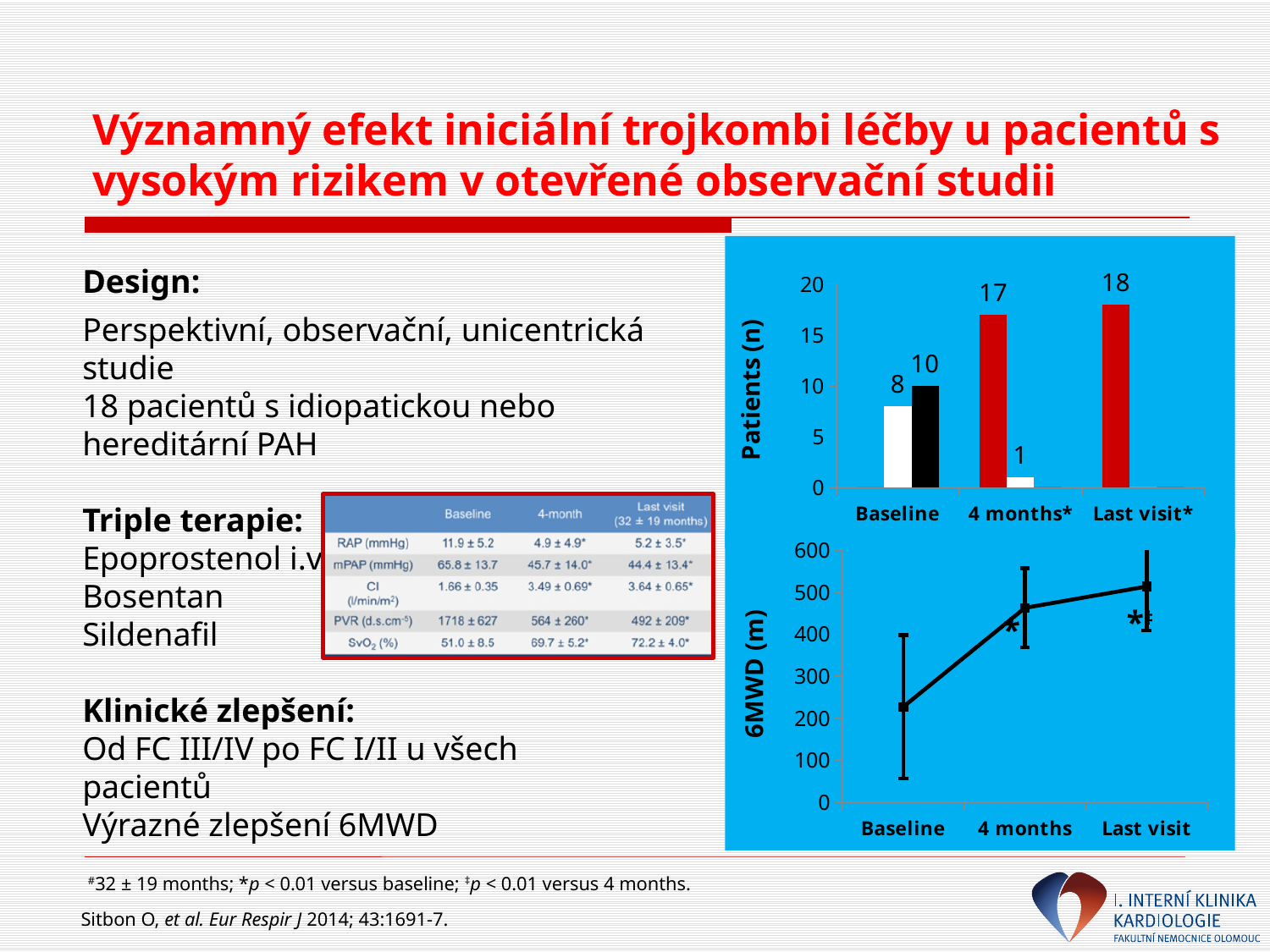
In the bottom chart (6MWD (m)), do the values rise or fall from Baseline to Last visit? rise In the top chart (Patients (n)), what is the value of the red bar at Last visit*? 18 In the top chart (Patients (n)), what is the value of the black bar at Baseline? 10 In the bottom chart (6MWD (m)), is the value at Baseline greater or less than 300? less In the top chart (Patients (n)), what is the difference between the red bar at Last visit* and the red bar at 4 months*? 1 In the top chart (Patients (n)), what is the value of the white bar at Baseline? 8 In the top chart (Patients (n)), what is the value of the red bar at 4 months*? 17 In the top chart (Patients (n)), which category has the tallest bar? Last visit* What type of chart is the bottom chart (6MWD (m))? line chart In the top chart (Patients (n)), what is the difference between the black bar and the white bar at Baseline? 2 In the top chart (Patients (n)), how many categories are shown on the x axis? 3 In the top chart (Patients (n)), what is the value of the white bar at 4 months*? 1